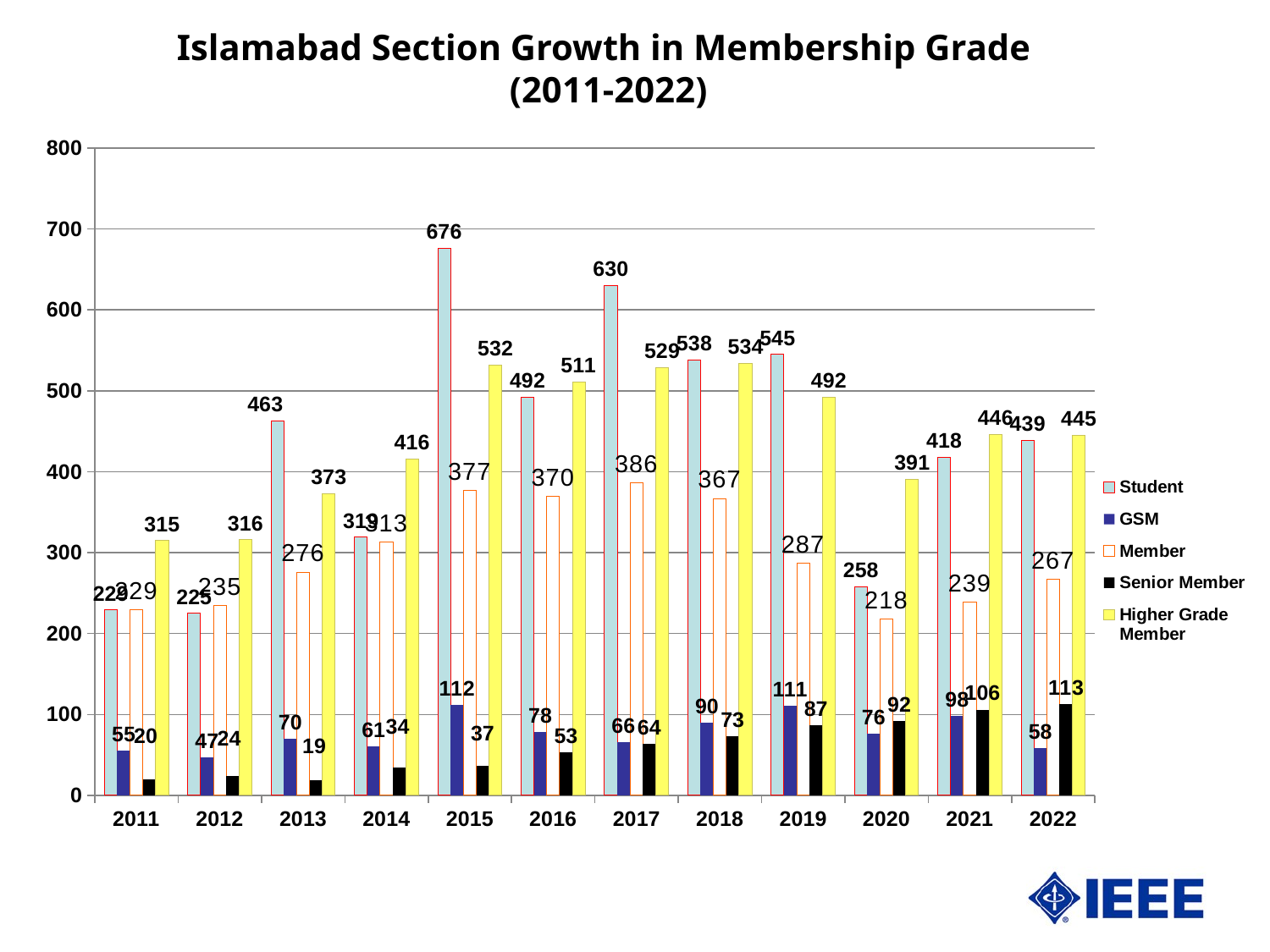
Is the Member value for 2015 greater or less than 300? greater In which year is the Senior Member value lowest? 2013 How many years are shown on the x axis? 12 What is the Student value for 2015? 676 What is the difference between the Student values for 2015 and 2017? 46 What kind of chart is shown on the slide? bar chart Which is larger in 2020, the GSM value or the Senior Member value? Senior Member How many series does the legend list? 5 Do the Senior Member values generally rise or fall from 2011 to 2022? rise In which year is the Student value highest? 2015 What is the Senior Member value for 2022? 113 What is the Higher Grade Member value for 2019? 492